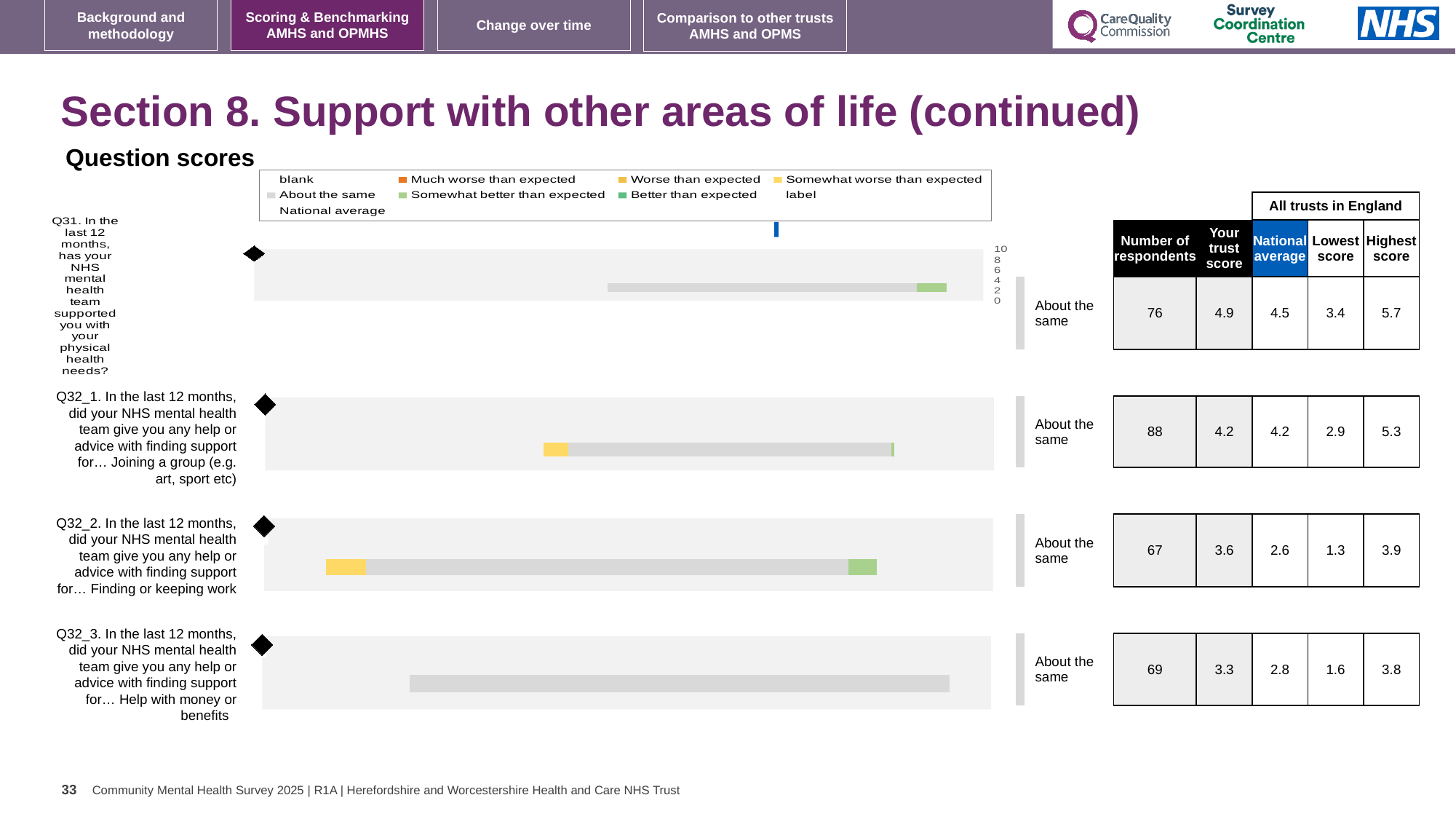
For the Q31 chart (physical health needs), what is the 'Your trust score' value? 4.9 What benchmark label is shown next to each of the four question charts? About the same Which question chart has the highest 'Your trust score'? Q31 For the Q32_1 chart (joining a group), how many respondents are there? 88 For the Q32_3 chart (help with money or benefits), what is the highest score among all trusts in England? 3.8 Which question chart has the lowest 'Your trust score'? Q32_3 For the Q32_2 chart (finding or keeping work), what is the difference between the trust score and the national average? 1.0 How many entries does the legend above the charts list? 9 What kind of chart is used to show the question scores on this slide? Bar chart For the Q31 chart, which is larger: the trust score or the national average? Trust score How many question charts are shown on the slide? 4 For the Q32_2 chart (finding or keeping work), what is the national average? 2.6